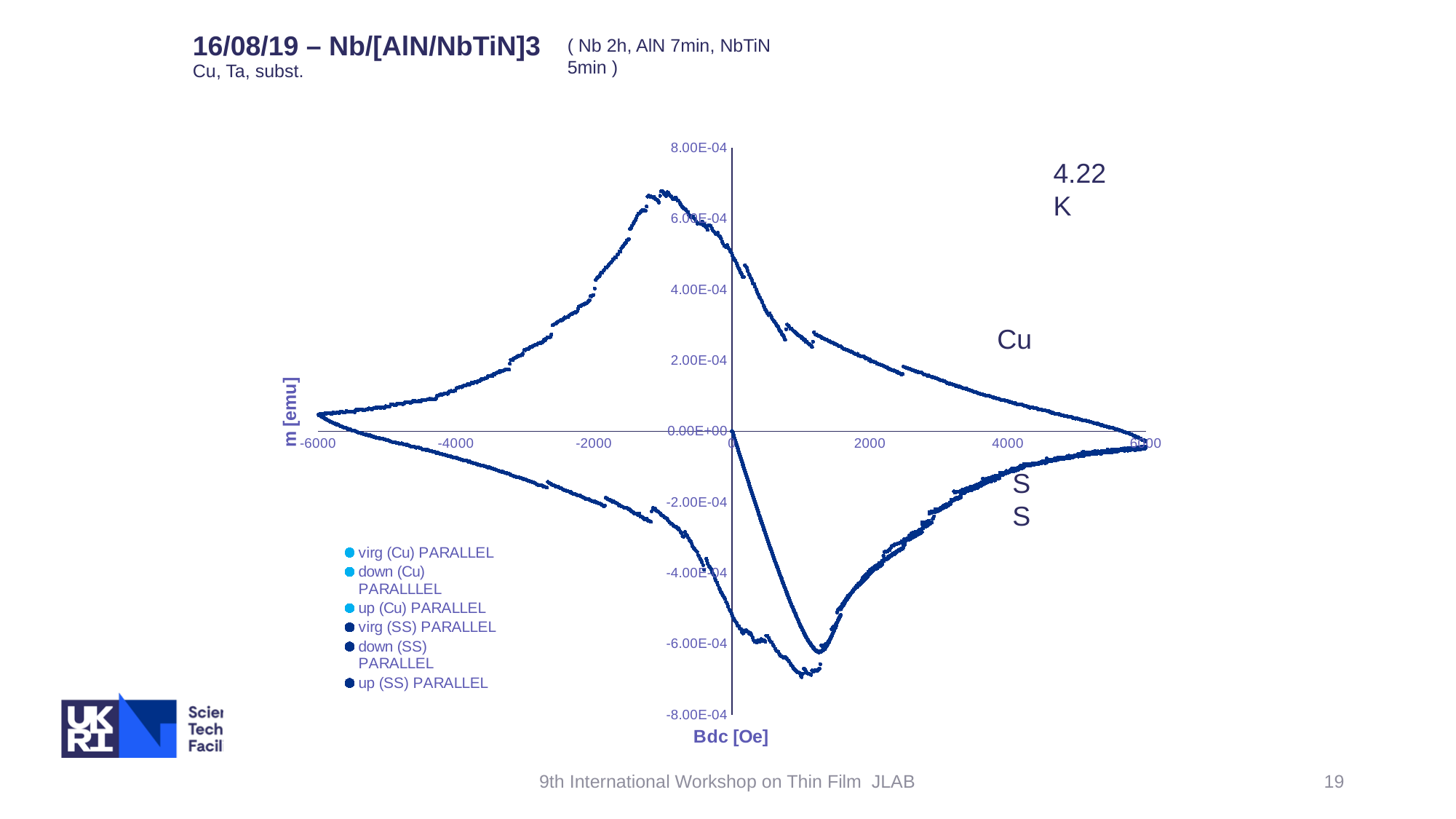
Is the peak value of the upper branch of the loop (near -1000 Oe) greater or less than 6.00E-04? greater How many series does the legend list? 6 What is the label of the y axis? m [emu] Is the minimum value of the lower branch of the loop (near 1000 Oe) greater or less than -6.00E-04? less What is the lowest value shown on the x axis? -6000 Is the value of the upper branch at Bdc = 4000 greater or less than 2.00E-04? less What is the highest value shown on the y axis? 8.00E-04 Does the upper branch of the loop rise or fall as Bdc increases from 0 to 6000? fall What kind of chart is shown on the slide? scatter chart What is the label of the x axis? Bdc [Oe]